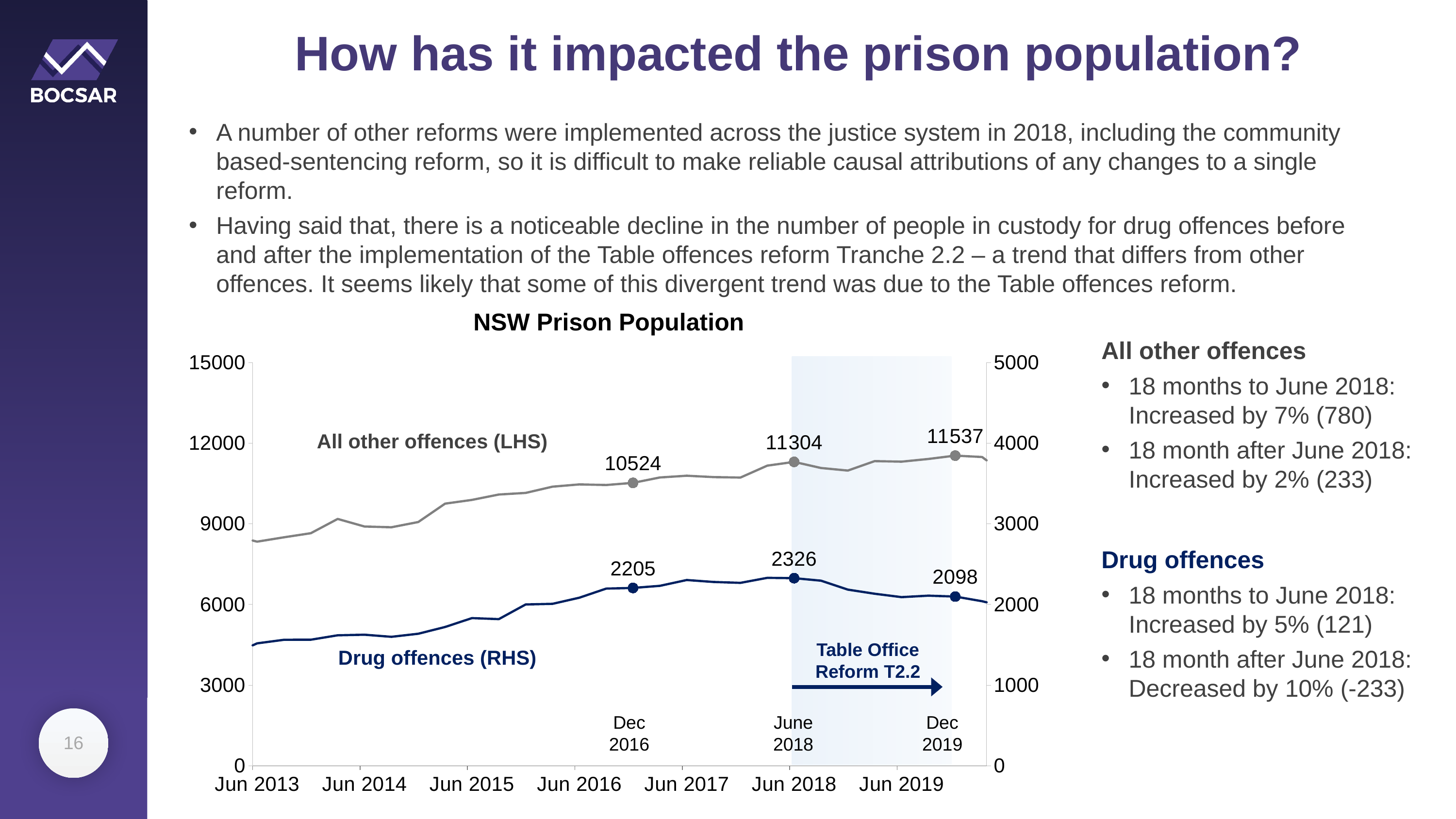
What is the title of the chart? NSW Prison Population What is the difference between the Drug offences values in June 2018 and Dec 2019? 228 Does the Drug offences line rise or fall between June 2018 and Dec 2019? Fall What is the value for Drug offences in June 2018? 2326 What is the value for All other offences in Dec 2016? 10524 Of the three labelled Drug offences points, which date has the highest value? June 2018 What type of chart is shown on the slide? Line chart By how much did All other offences increase between June 2018 and Dec 2019? 233 What is the value for All other offences in June 2018? 11304 Is the value for All other offences in Jun 2013 greater or less than 9000? less How many series are plotted in the chart? 2 What is the value for Drug offences in Dec 2019? 2098